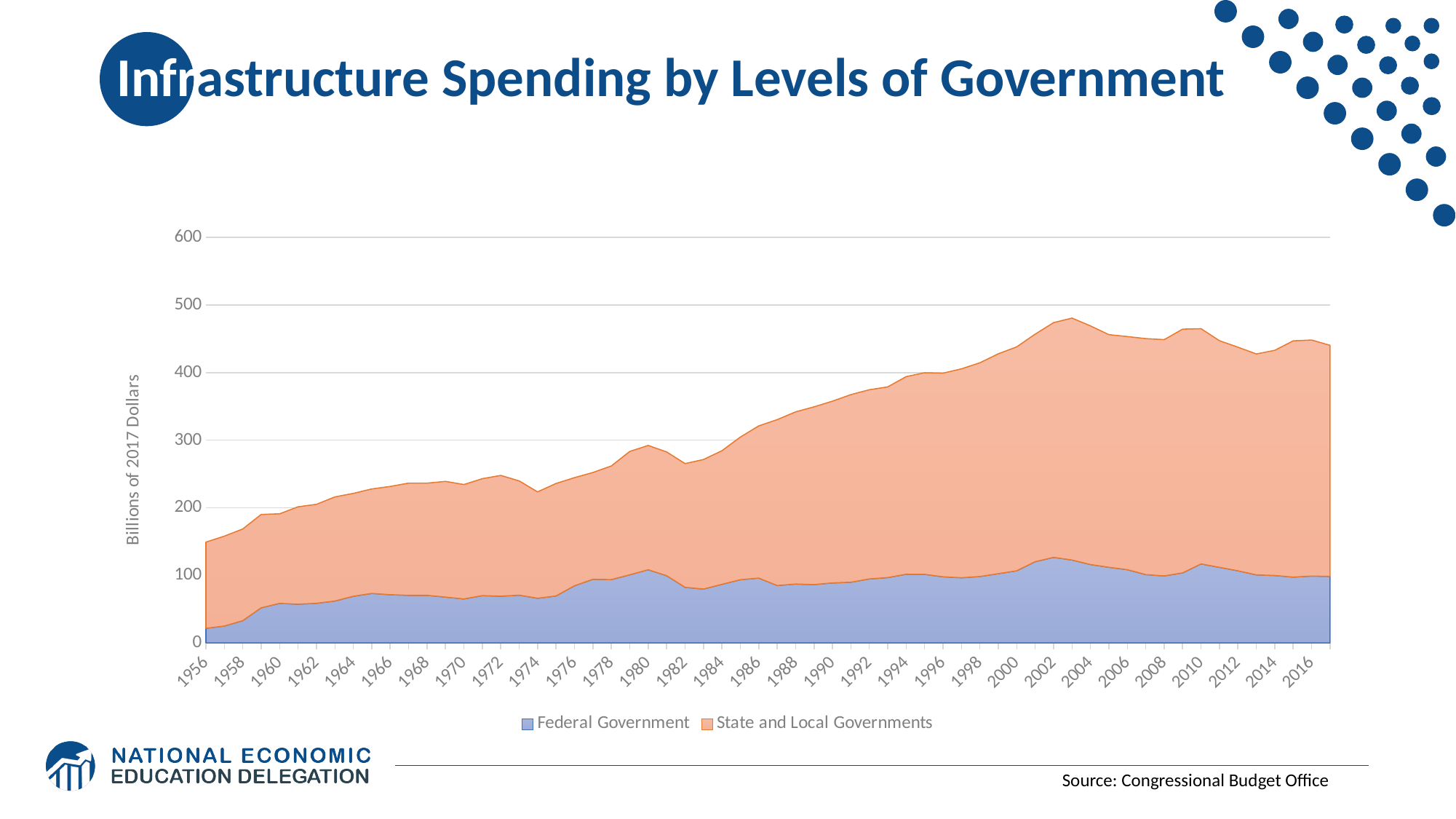
What is the label on the vertical axis? Billions of 2017 Dollars Is the total infrastructure spending in 1956 greater or less than 200? less In 2016, which series accounts for the larger share of spending, Federal Government or State and Local Governments? State and Local Governments Does total infrastructure spending generally rise or fall from 1956 to 2016? rise Is the Federal Government value in 2002 greater or less than 100? greater Is the total infrastructure spending (top of the stacked area) in 2016 greater or less than 400? greater What kind of chart is shown on the slide? Stacked area chart How many year labels are shown on the x axis? 31 What are the two series named in the legend? Federal Government; State and Local Governments How many series does the legend list? 2